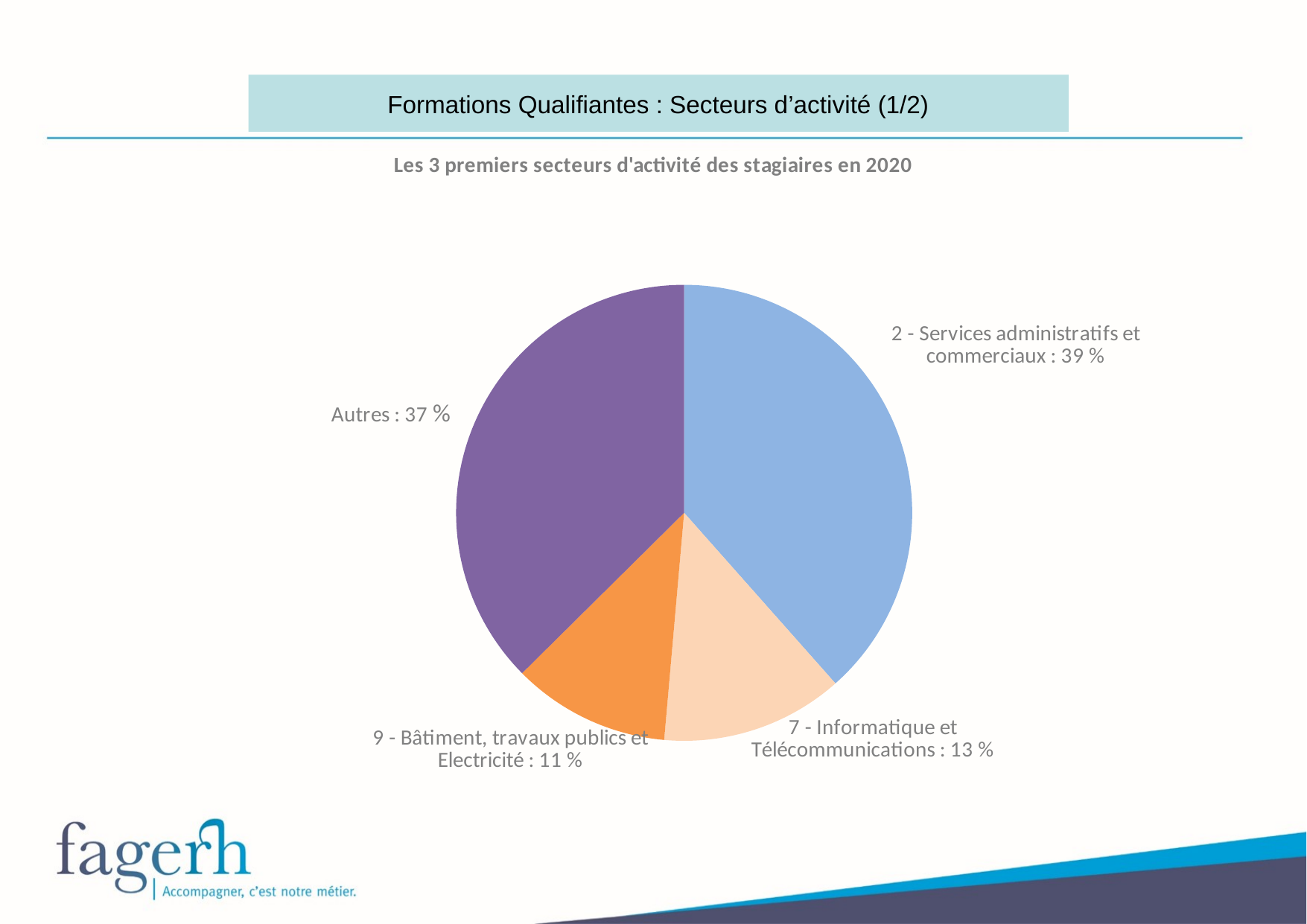
What kind of chart is shown on the slide? Pie chart How many slices does the pie chart have? 4 What is the difference in percentage points between '7 - Informatique et Télécommunications' and '9 - Bâtiment, travaux publics et Electricité'? 2 What is the value shown for '9 - Bâtiment, travaux publics et Electricité'? 11 % Which is larger: the share for '7 - Informatique et Télécommunications' or for '9 - Bâtiment, travaux publics et Electricité'? 7 - Informatique et Télécommunications Which category has the largest slice of the pie? 2 - Services administratifs et commerciaux What is the difference in percentage points between '2 - Services administratifs et commerciaux' and 'Autres'? 2 What is the value shown for '7 - Informatique et Télécommunications'? 13 % What is the value shown for 'Autres'? 37 % Which category has the smallest slice of the pie? 9 - Bâtiment, travaux publics et Electricité What is the title of the chart? Les 3 premiers secteurs d'activité des stagiaires en 2020 What share of the pie does '2 - Services administratifs et commerciaux' represent? 39 %